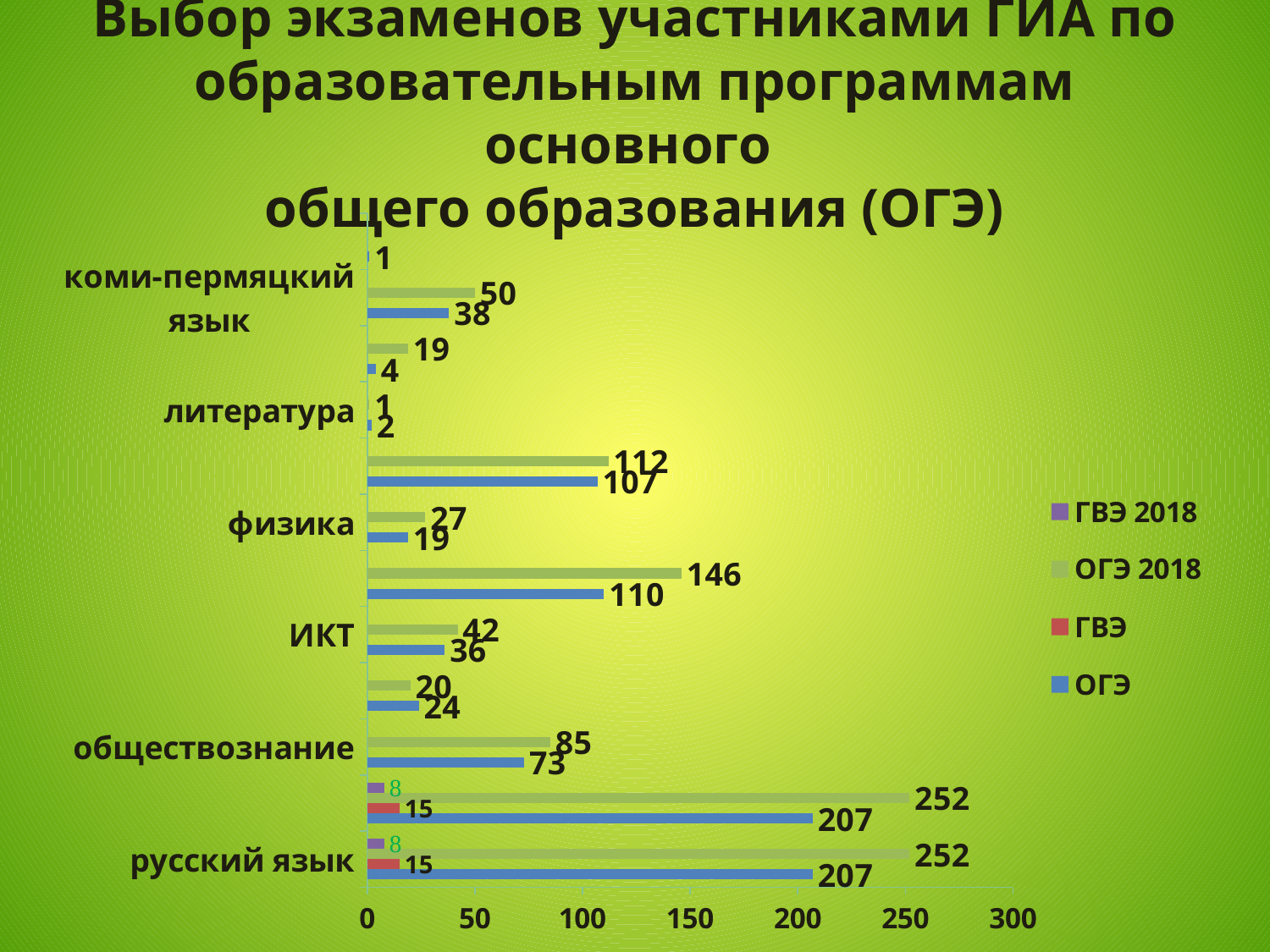
What is the ОГЭ value for русский язык? 207 Which is larger for ИКТ: the ОГЭ 2018 value or the ОГЭ value? ОГЭ 2018 What is the ГВЭ value for русский язык? 15 What is the ОГЭ 2018 value for обществознание? 85 What is the difference between the ОГЭ 2018 and ОГЭ values for обществознание? 12 What is the ОГЭ value for коми-пермяцкий язык? 38 What is the ОГЭ 2018 value for русский язык? 252 How many series does the legend list? 4 What is the difference between the ОГЭ 2018 and ОГЭ values for русский язык? 45 What is the ОГЭ 2018 value for физика? 27 What type of chart is shown on the slide? bar chart What is the ОГЭ value for ИКТ? 36